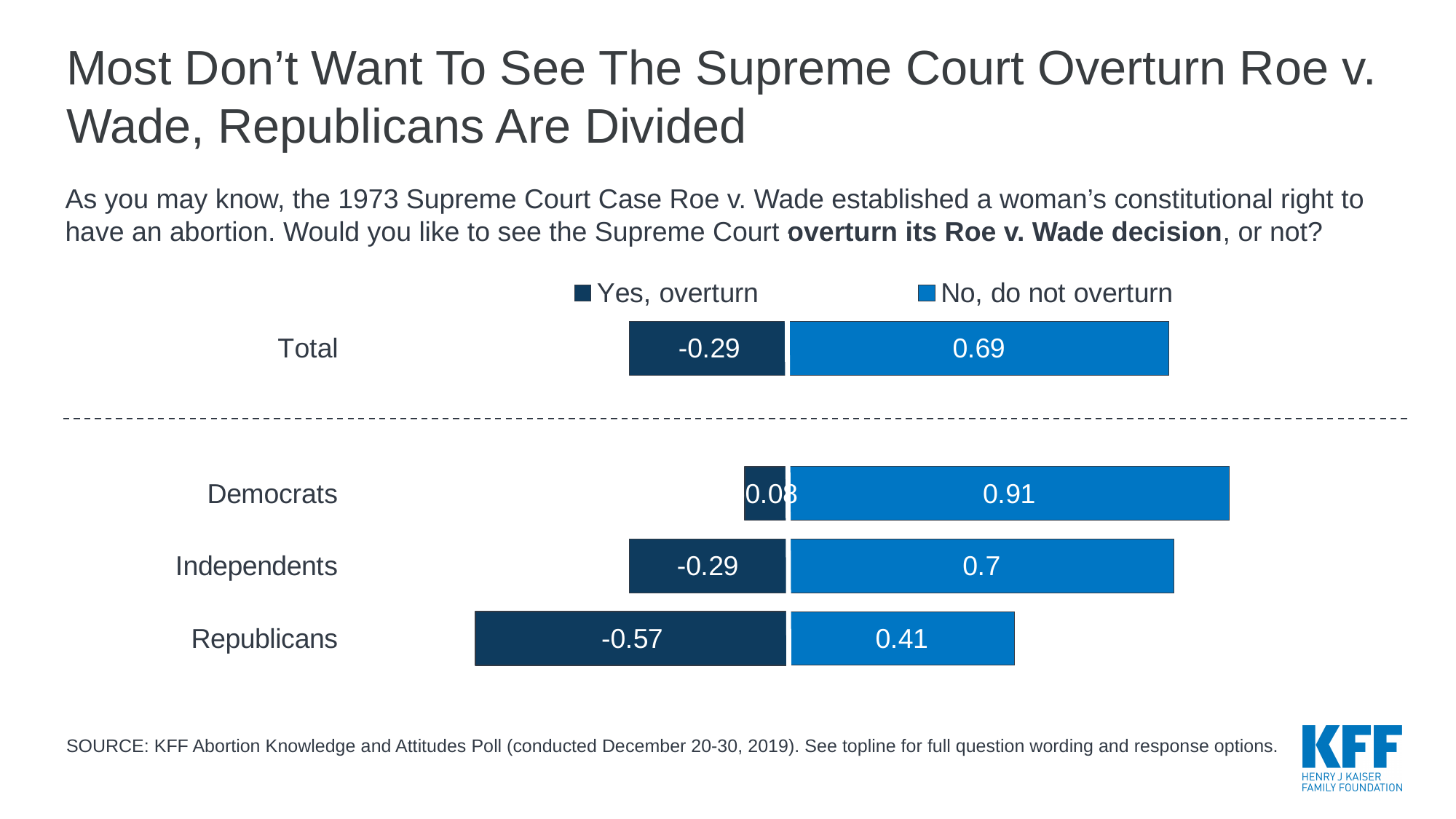
How many groups (categories) are plotted in the chart? 4 Which is larger, the "No, do not overturn" value for Republicans or for Independents? Independents What is the value for "No, do not overturn" for the Total group? 0.69 What is the difference between the "No, do not overturn" values for Democrats and Republicans? 0.5 What kind of chart is shown on the slide? Bar chart What is the value for "No, do not overturn" for Democrats? 0.91 Which group has the highest value for "No, do not overturn"? Democrats Which group has the lowest value for "No, do not overturn"? Republicans What is the value for "Yes, overturn" for the Total group? -0.29 What is the value for "No, do not overturn" for Independents? 0.7 How many series does the legend list? 2 What is the value for "Yes, overturn" for Republicans? -0.57